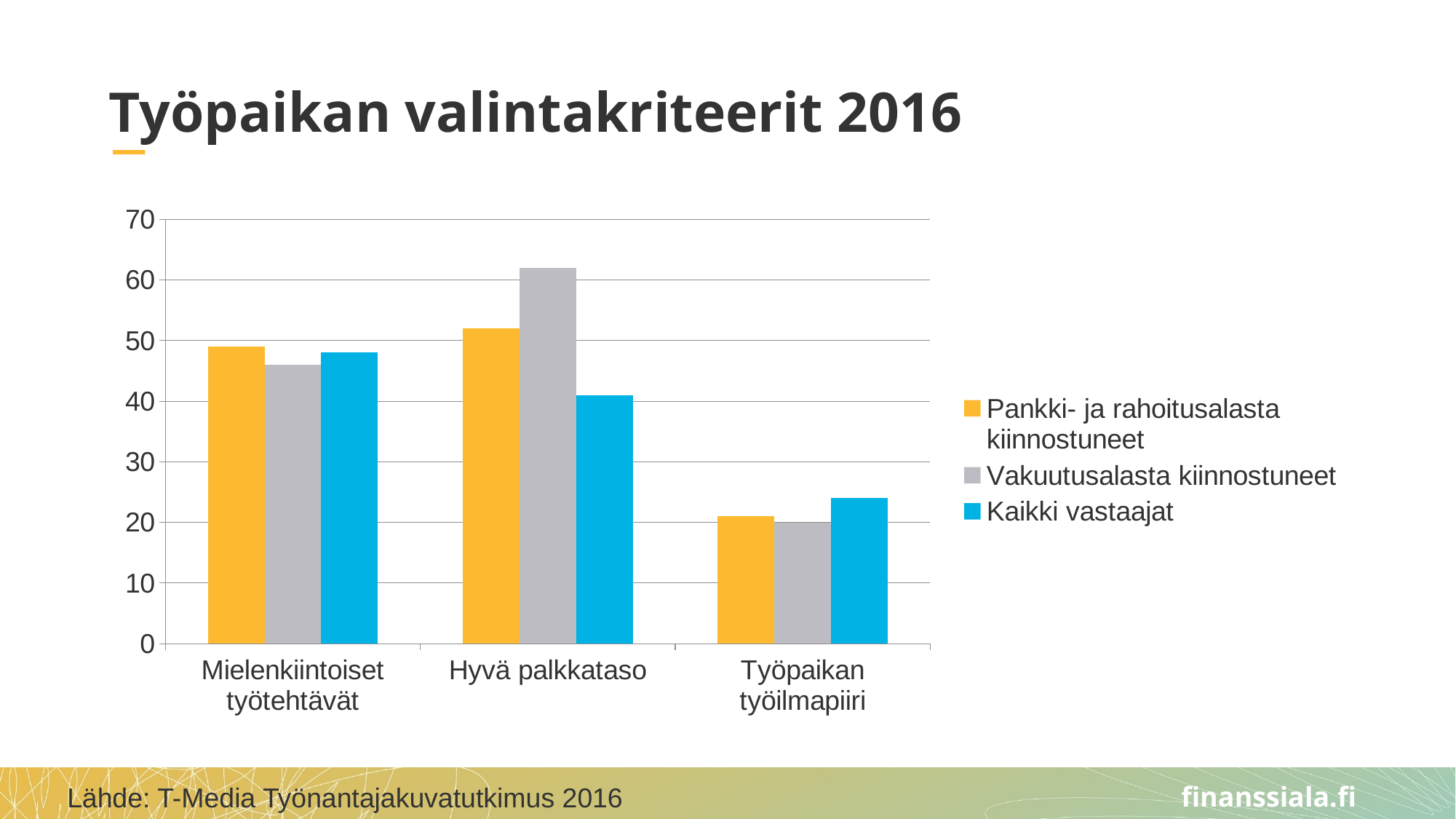
For Kaikki vastaajat, which is larger: Hyvä palkkataso or Työpaikan työilmapiiri? Hyvä palkkataso Is the value for Vakuutusalasta kiinnostuneet at Hyvä palkkataso greater or less than 50? greater Do the values for Kaikki vastaajat rise or fall from left to right across the categories? fall How many series does the legend list? 3 What kind of chart is shown on the slide? bar chart Which category has the highest bar for Vakuutusalasta kiinnostuneet? Hyvä palkkataso Which category has the lowest bar for Kaikki vastaajat? Työpaikan työilmapiiri Which series is shown in blue in the legend? Kaikki vastaajat Is the value for Kaikki vastaajat at Hyvä palkkataso greater or less than 50? less What is the title of the chart slide? Työpaikan valintakriteerit 2016 How many categories are shown on the x axis of the chart? 3 For Hyvä palkkataso, which is larger: Vakuutusalasta kiinnostuneet or Kaikki vastaajat? Vakuutusalasta kiinnostuneet